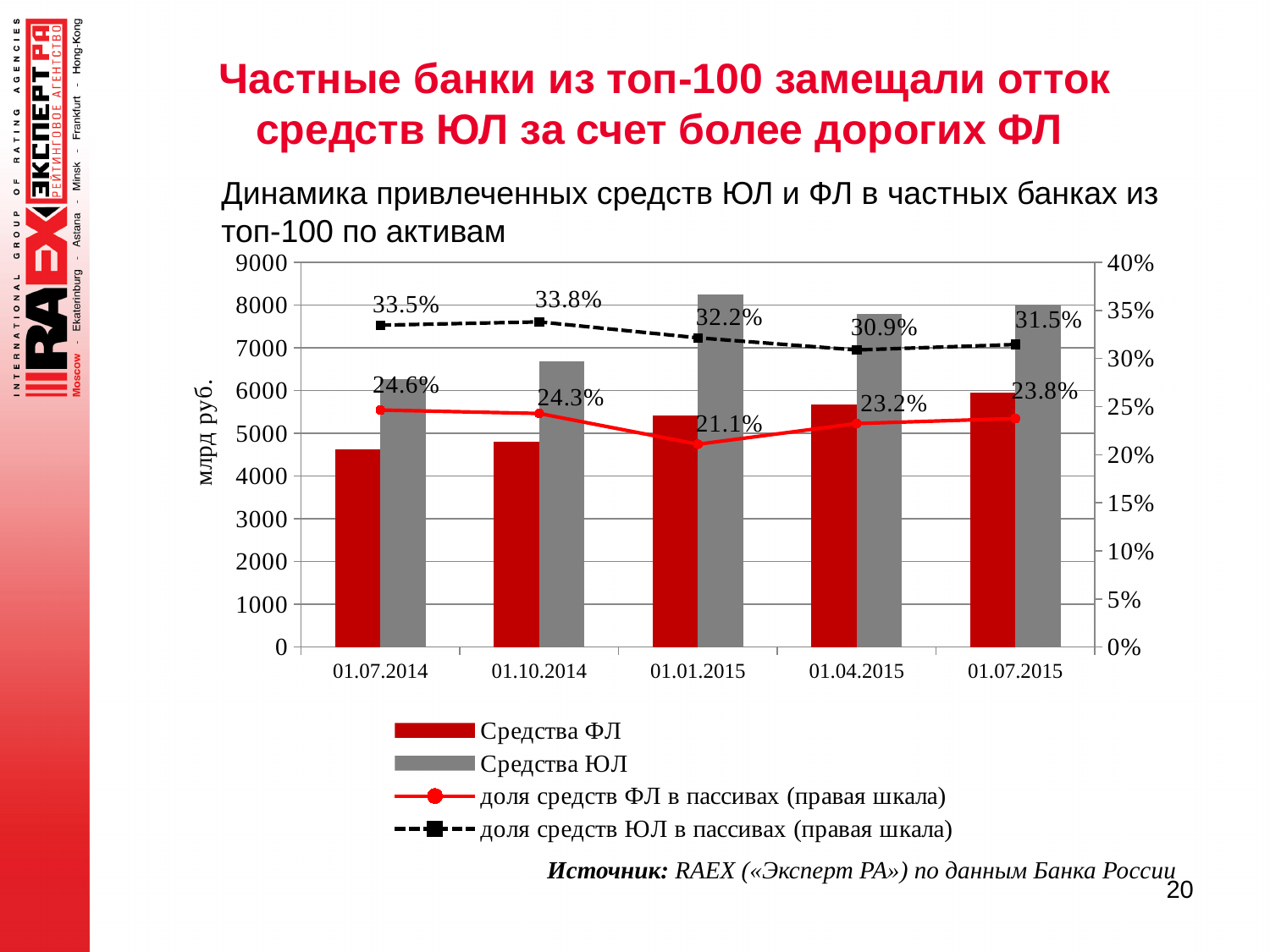
Which is larger: «доля средств ФЛ в пассивах» on 01.07.2014 or on 01.07.2015? 01.07.2014 Do the «Средства ФЛ» bars rise or fall from 01.07.2014 to 01.07.2015? rise How many series does the legend list? 4 How many dates are shown on the x axis of the chart? 5 Is the «Средства ФЛ» bar for 01.07.2014 greater or less than 5000? less On which date is «доля средств ЮЛ в пассивах» the highest? 01.10.2014 Is the «Средства ЮЛ» bar for 01.01.2015 greater or less than 8000? greater On 01.07.2015, by how many percentage points does «доля средств ЮЛ в пассивах» exceed «доля средств ФЛ в пассивах»? 7.7 percentage points On which date is the «Средства ЮЛ» bar the lowest? 01.07.2014 What is the value of «доля средств ЮЛ в пассивах» on 01.10.2014? 33.8% On which date is «доля средств ФЛ в пассивах» the lowest? 01.01.2015 What is the value of «доля средств ФЛ в пассивах» on 01.01.2015? 21.1%